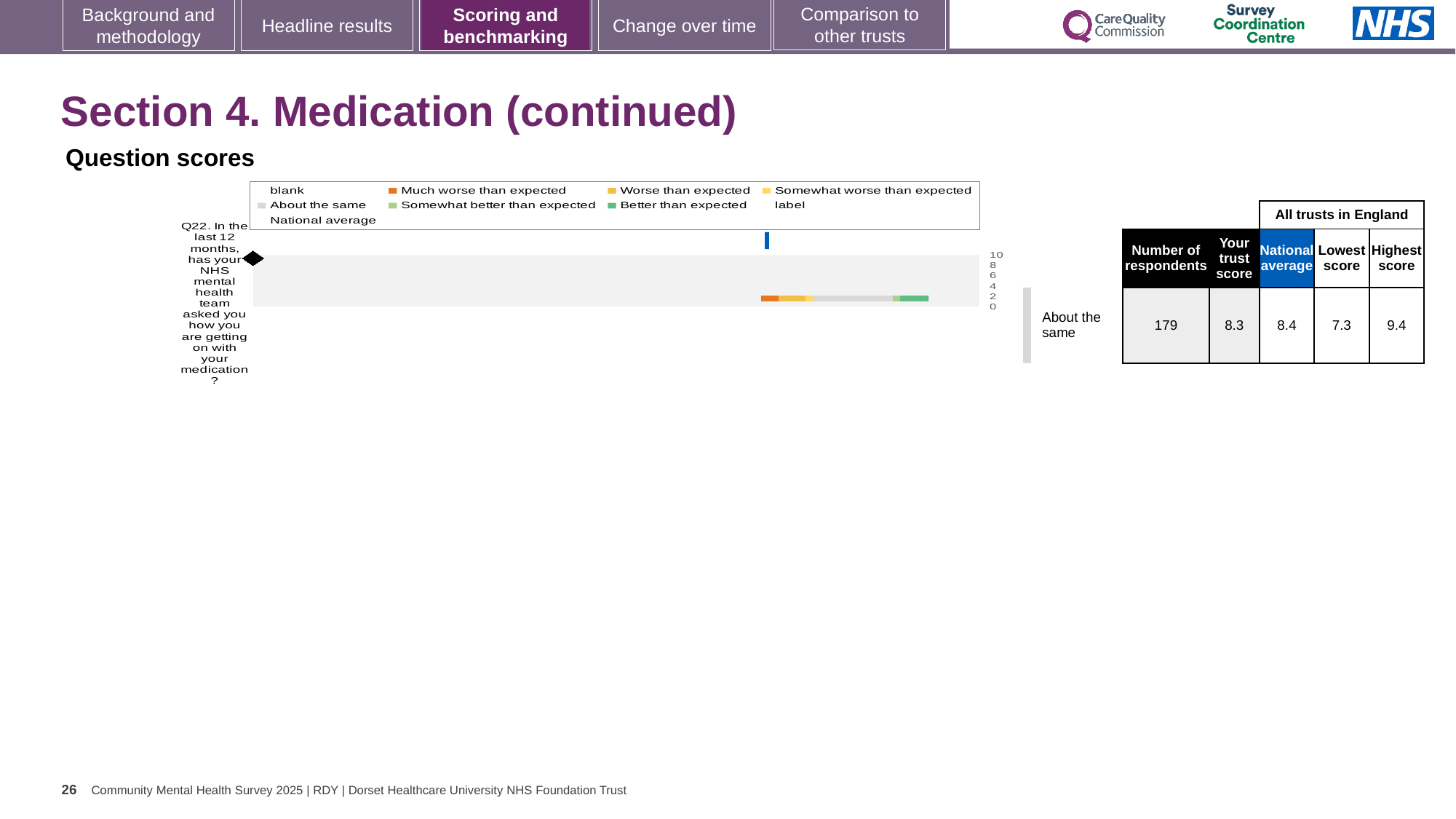
What is the highest score among all trusts in England for Q22? 9.4 What is the difference between the highest and lowest scores for Q22 across all trusts in England? 2.1 Which is larger for Q22, the trust score or the national average? National average What is the national average for Q22? 8.4 How many survey questions are plotted on the chart? 1 What kind of chart is used to show the question scores? bar chart What colour represents 'Much worse than expected' in the chart legend? Orange What is the lowest score among all trusts in England for Q22? 7.3 What is the trust score for Q22 shown in the table next to the chart? 8.3 What benchmarking category is Q22 assigned to on the chart? About the same By how much does the national average exceed the trust score for Q22? 0.1 How many respondents answered Q22? 179